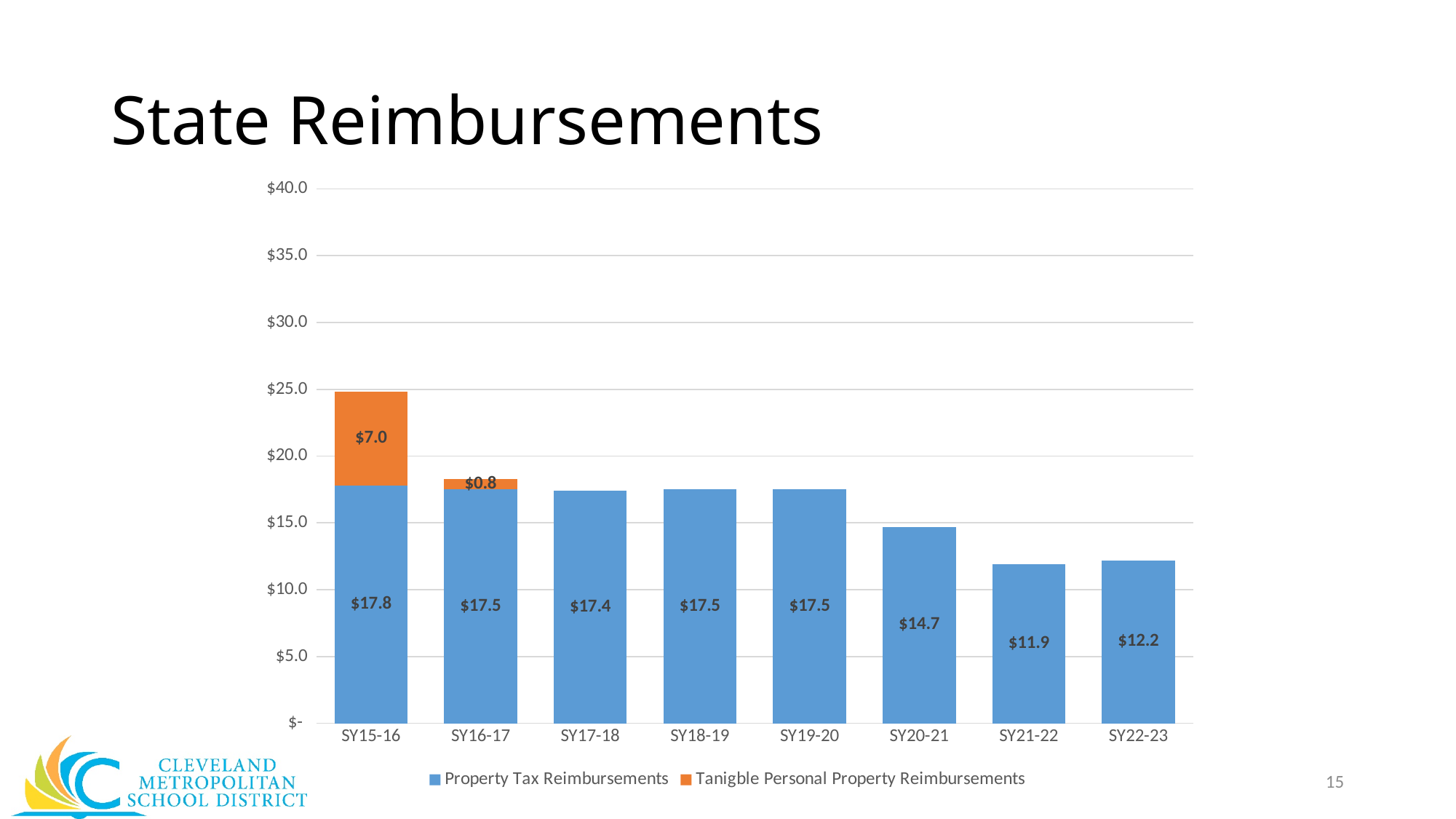
Is the Property Tax Reimbursements value for SY22-23 larger or smaller than the value for SY21-22? larger Which school year has the highest Property Tax Reimbursements value? SY15-16 How many school years are shown on the x axis? 8 What is the difference between the Property Tax Reimbursements values for SY19-20 and SY20-21? $2.8 What is the Property Tax Reimbursements value for SY21-22? $11.9 What is the Property Tax Reimbursements value for SY15-16? $17.8 What type of chart is shown on the slide? stacked bar chart What is the Tangible Personal Property Reimbursements value for SY16-17? $0.8 What is the Tangible Personal Property Reimbursements value for SY15-16? $7.0 Which school year has the lowest Property Tax Reimbursements value? SY21-22 What is the total of the stacked bar for SY15-16? $24.8 How many series does the legend list? 2